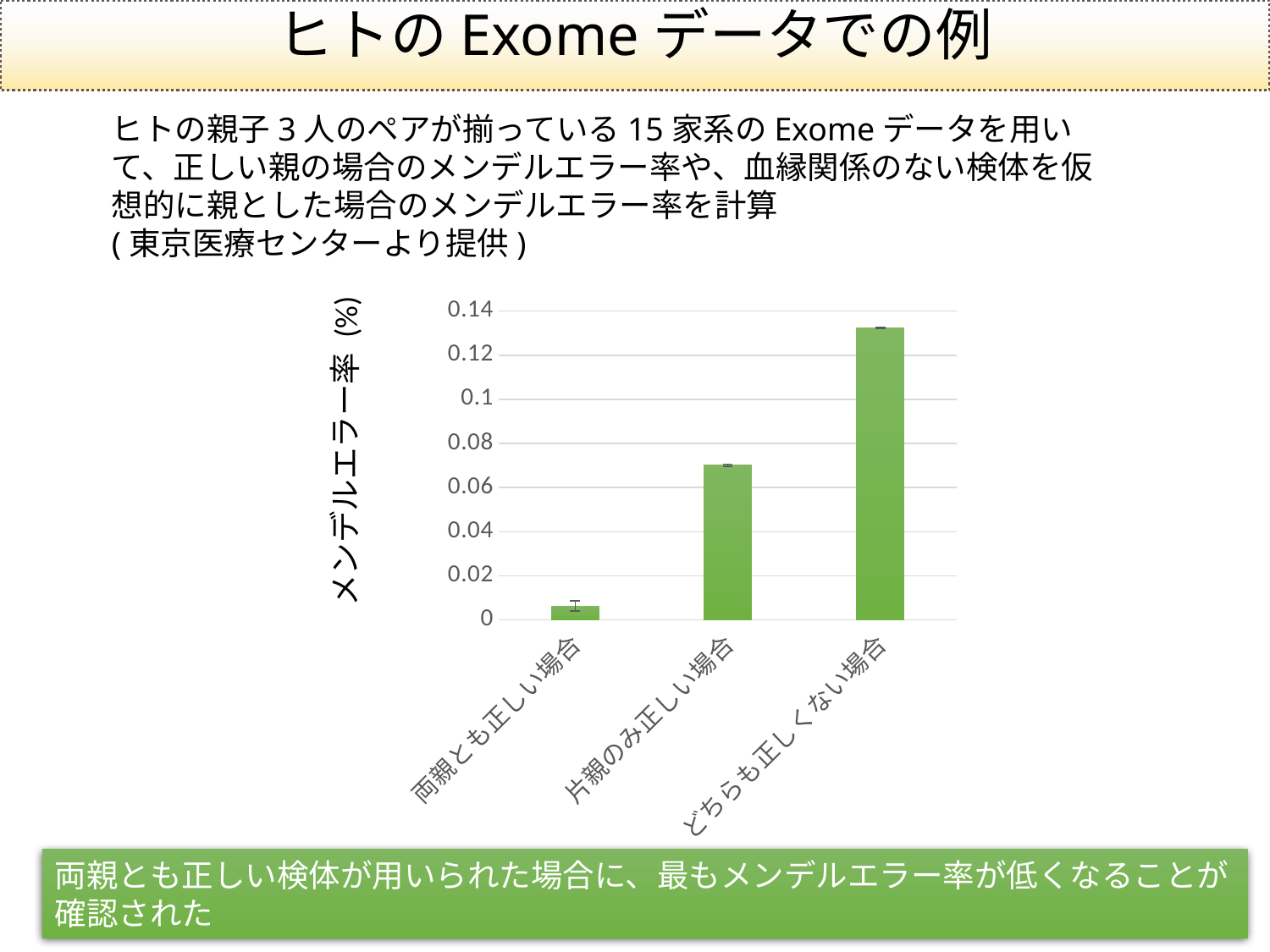
Is the value for どちらも正しくない場合 greater or less than 0.12? greater What is the highest tick value shown on the vertical axis? 0.14 Is the value for 片親のみ正しい場合 greater or less than 0.08? less Which category has the lowest メンデルエラー率? 両親とも正しい場合 What kind of chart is shown on the slide? bar chart How many categories are plotted on the x axis of the chart? 3 Is the value for 両親とも正しい場合 greater or less than 0.02? less Do the bar values rise or fall from left to right along the x axis? rise What is the label of the vertical axis of the chart? メンデルエラー率 (%) Which is larger, the value for 片親のみ正しい場合 or the value for どちらも正しくない場合? どちらも正しくない場合 Which category has the highest メンデルエラー率? どちらも正しくない場合 Which is larger, the value for 両親とも正しい場合 or the value for 片親のみ正しい場合? 片親のみ正しい場合